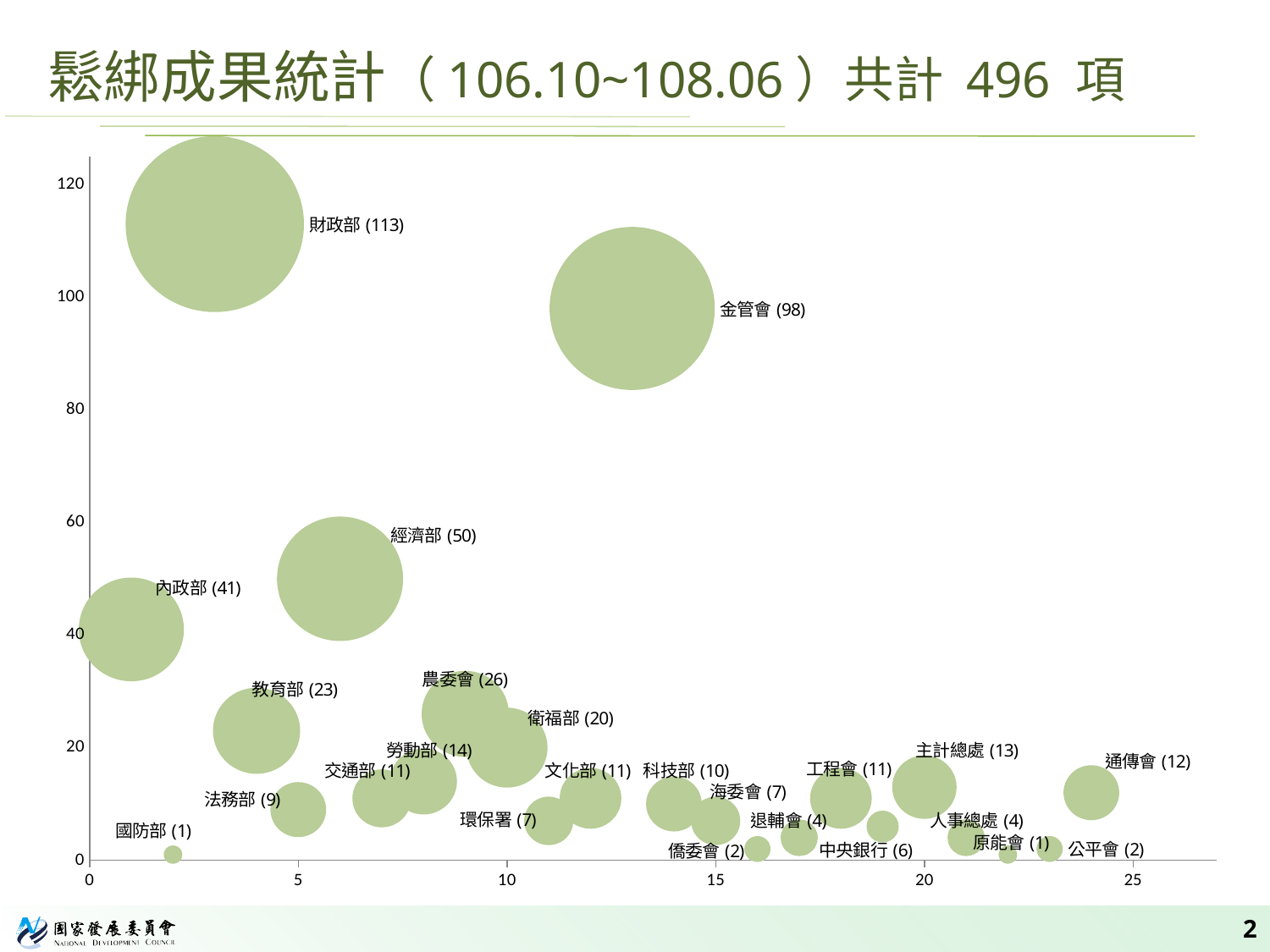
What kind of chart is shown on the slide? bubble chart According to the slide title, what is the total number of items (共計) covered by the statistics? 496 項 Which has a larger value, 農委會 or 衛福部? 農委會 What is the difference between the values for 財政部 and 金管會? 15 Which agency has the highest value in the chart? 財政部 What is the value shown for 經濟部? 50 Which has a larger value, 內政部 or 經濟部? 經濟部 What is the value shown for 財政部? 113 Is the value for 金管會 greater or less than 80? greater How many agencies (bubbles) are plotted in the chart? 24 What is the value shown for 教育部? 23 What is the value shown for 金管會? 98